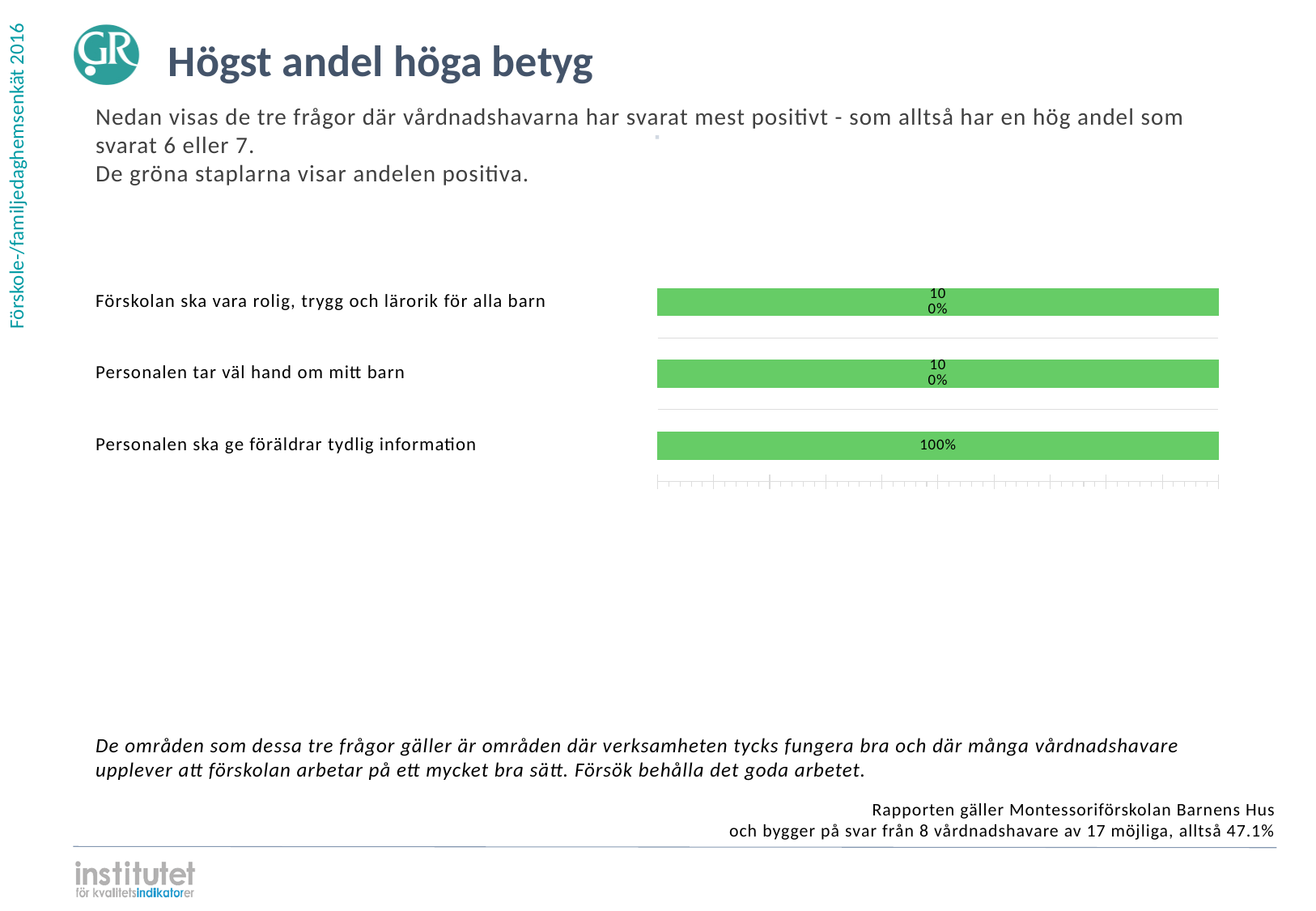
Which category is listed at the top of the chart? Förskolan ska vara rolig, trygg och lärorik för alla barn What colour are the bars in the chart? Green How many categories (questions) are shown in the chart? 3 What is the value for "Personalen tar väl hand om mitt barn"? 100% Is the value for "Förskolan ska vara rolig, trygg och lärorik för alla barn" greater or less than 50%? greater What is the value for "Personalen ska ge föräldrar tydlig information"? 100% What is the difference between the values for "Personalen tar väl hand om mitt barn" and "Personalen ska ge föräldrar tydlig information"? 0% Do all three bars in the chart show the same value? Yes, 100% What kind of chart is shown on the slide? Bar chart What is the value for "Förskolan ska vara rolig, trygg och lärorik för alla barn"? 100% What is the title of the slide containing the chart? Högst andel höga betyg